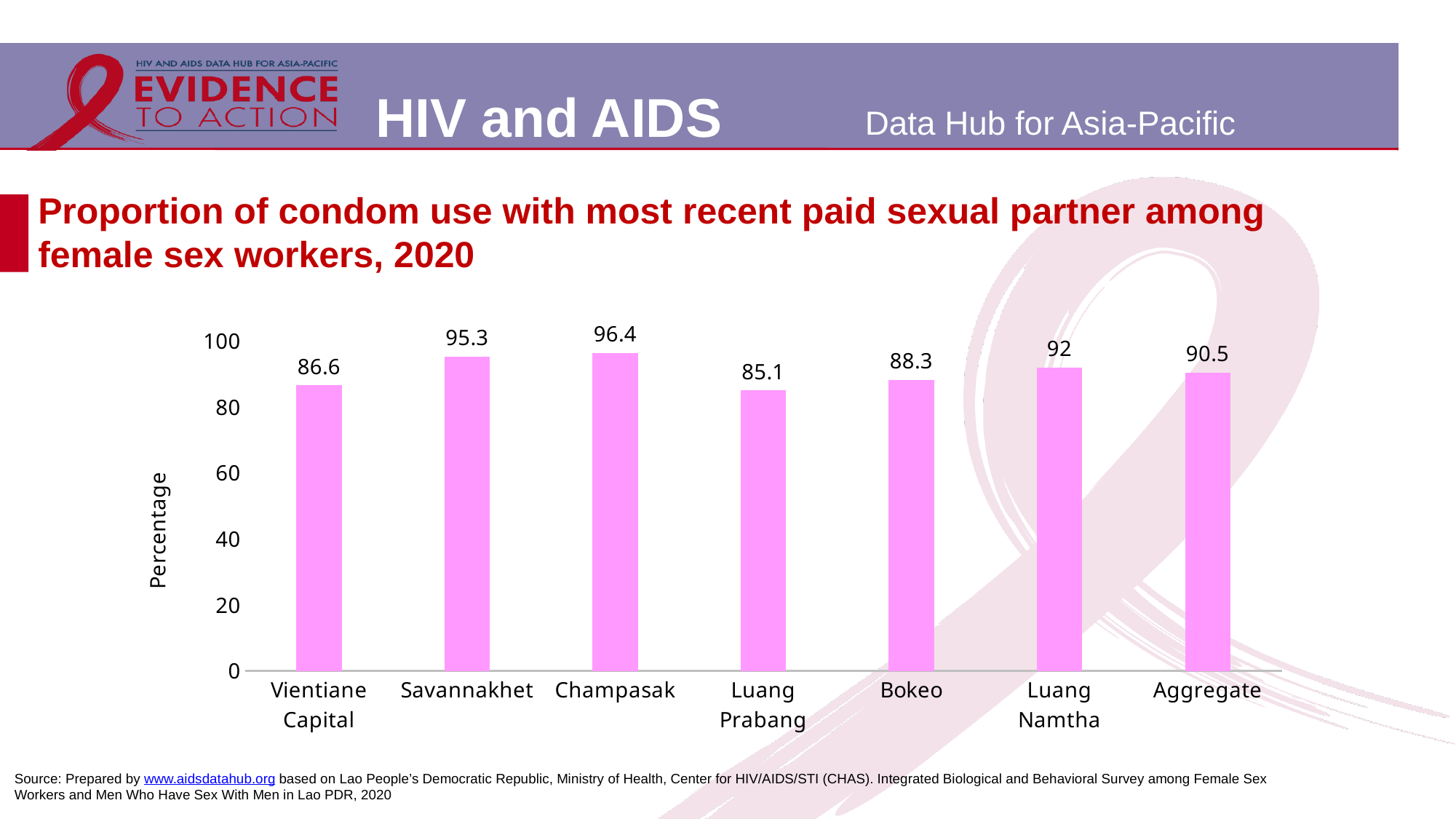
What is the Aggregate value? 90.5 What is the label of the y axis? Percentage What is the difference between the values for Savannakhet and Bokeo? 7 How many categories are shown on the x axis? 7 What is the value for Luang Namtha? 92 What kind of chart is shown on the slide? bar chart Is the value for Luang Prabang greater or less than 80? greater Which is larger, the value for Bokeo or the value for Vientiane Capital? Bokeo What is the difference between the values for Champasak and Luang Prabang? 11.3 Which category has the lowest value? Luang Prabang Which category has the highest value? Champasak What is the value for Vientiane Capital? 86.6